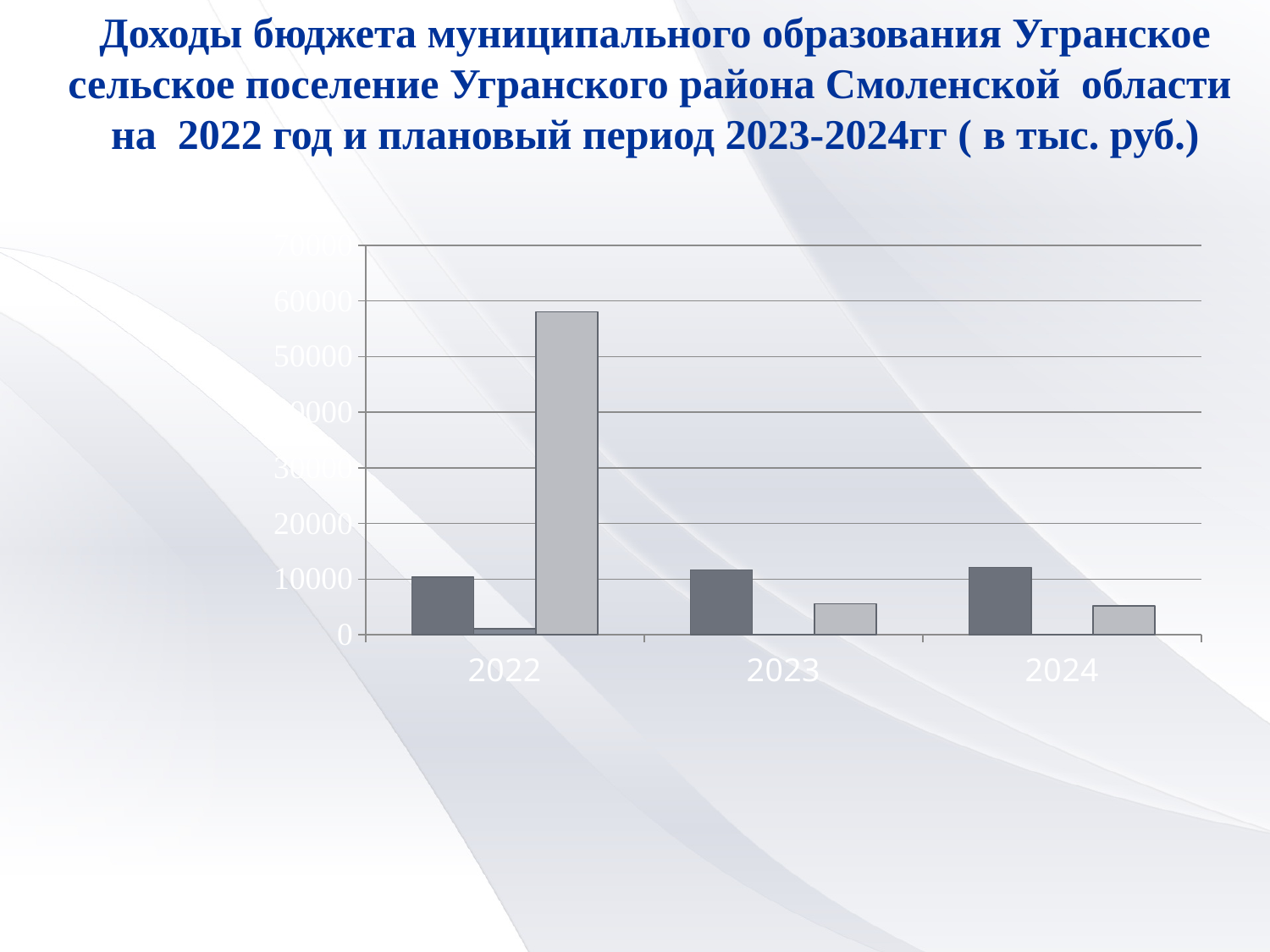
What kind of chart is shown on the slide? bar chart Do the light grey bars rise or fall from 2022 to 2024? fall What is the first year shown on the x axis of the chart? 2022 Which year has the tallest bar in the chart? 2022 How many years are shown on the x axis of the chart? 3 Which is larger: the light grey bar for 2022 or the light grey bar for 2023? 2022 In what units are the values in the chart expressed, according to the slide title? тыс. руб. Is the value of the tallest (light grey) bar for 2022 greater or less than 50000? greater For 2024, which bar is taller: the dark grey bar or the light grey bar? the dark grey bar Is the value of the light grey bar for 2023 greater or less than 10000? less Is the value of the light grey bar for 2024 greater or less than 10000? less